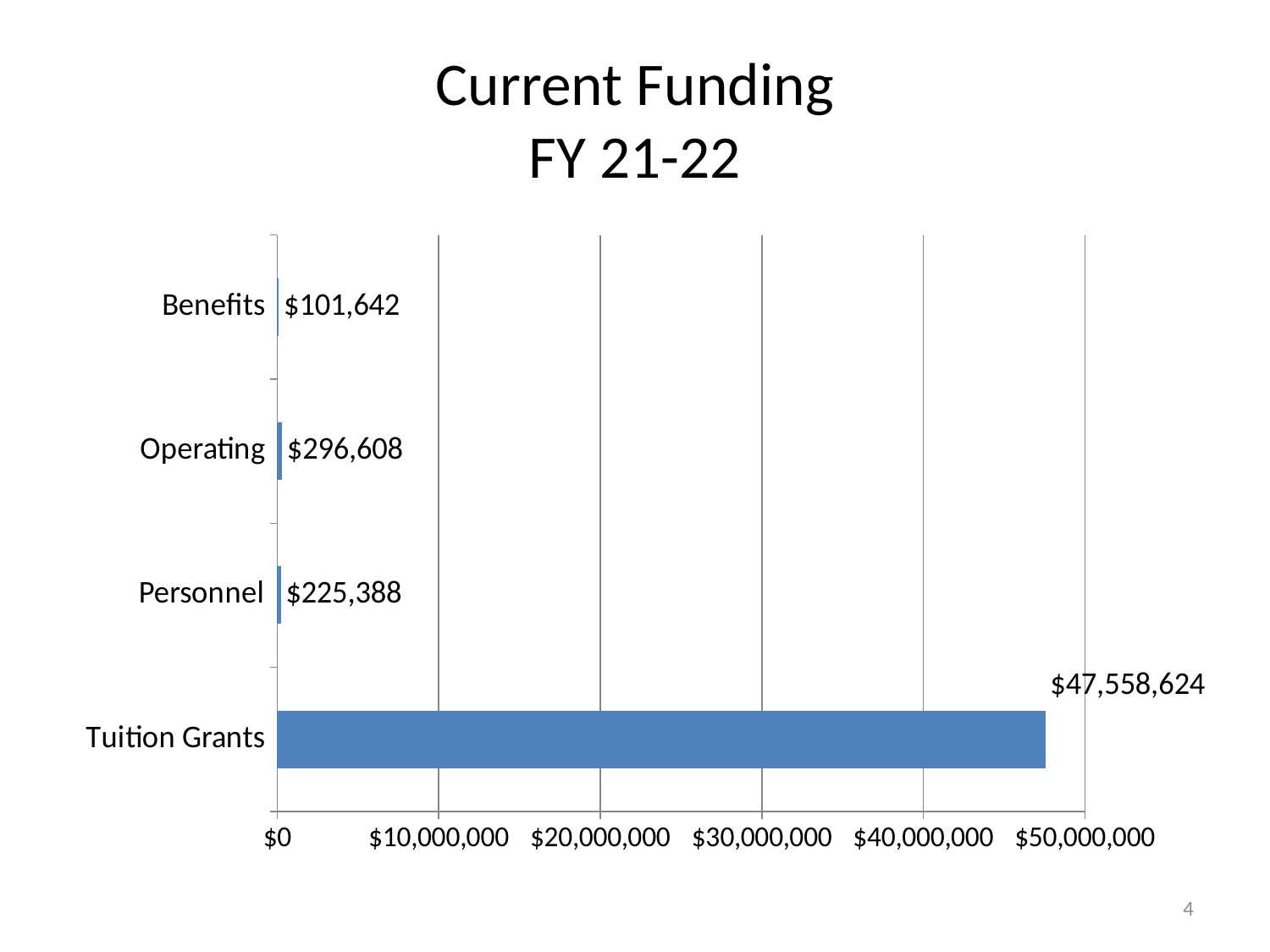
Which category has the lowest value? Benefits How many categories are shown in the chart? 4 Which category has the highest value? Tuition Grants What is the difference between the Operating and Personnel values? $71,220 What is the difference between the Personnel and Benefits values? $123,746 What kind of chart is shown on the slide? Bar chart What is the value for Personnel? $225,388 What is the value for Benefits? $101,642 What is the value for Tuition Grants? $47,558,624 Which is larger, the value for Operating or the value for Personnel? Operating What is the value for Operating? $296,608 Is the value for Tuition Grants greater or less than $40,000,000? greater